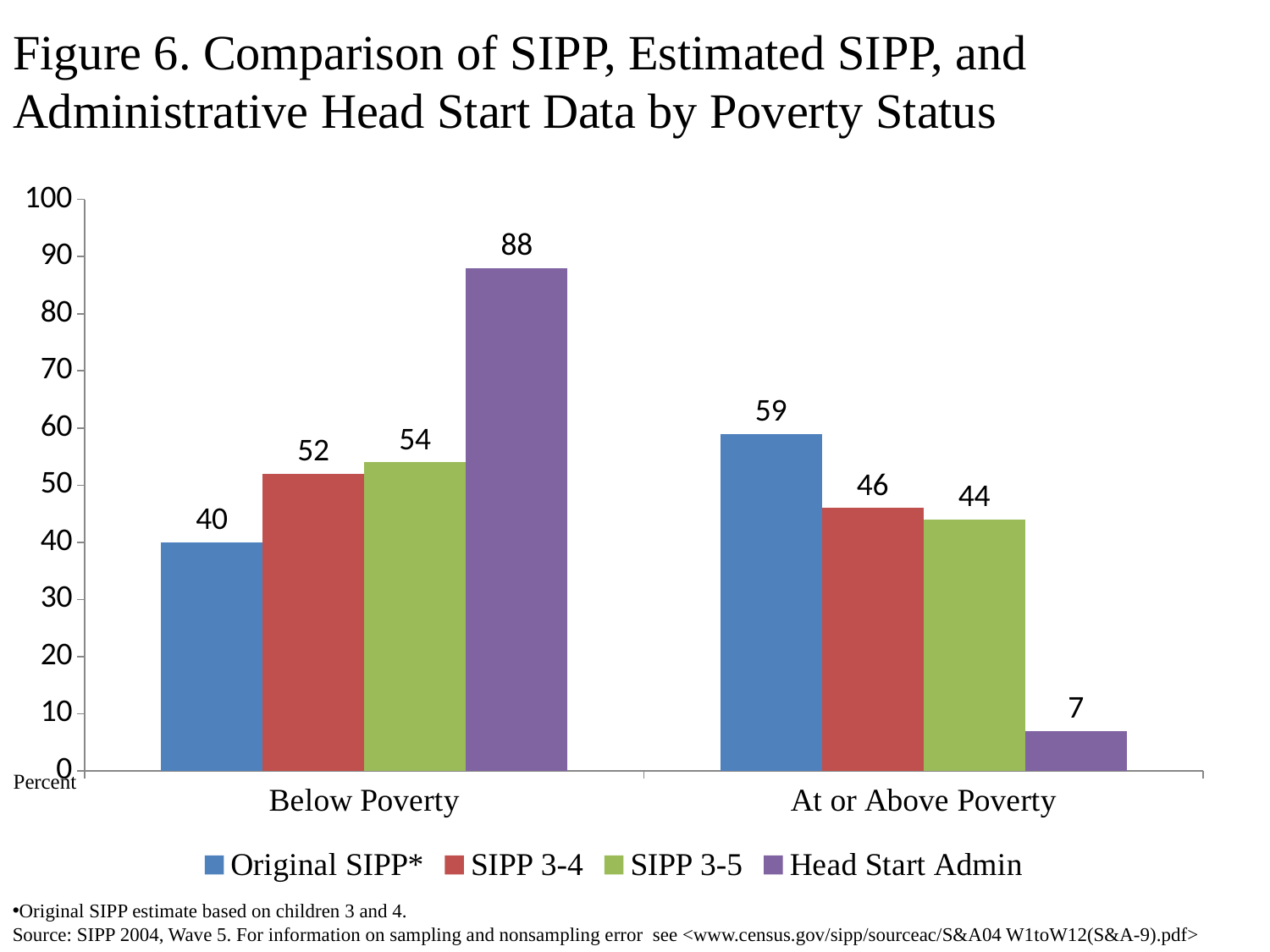
What is the Head Start Admin value for Below Poverty? 88 What is the SIPP 3-5 value for At or Above Poverty? 44 Which series has the lowest value for At or Above Poverty? Head Start Admin What colour are the Head Start Admin bars? Purple Which series has the highest value for Below Poverty? Head Start Admin What kind of chart is shown on the slide? Bar chart What is the SIPP 3-4 value for Below Poverty? 52 How many categories are shown on the x axis? 2 What is the Original SIPP* value for At or Above Poverty? 59 What is the difference between the Head Start Admin values for Below Poverty and At or Above Poverty? 81 How many series does the legend list? 4 Which is larger, the Original SIPP* value for Below Poverty or for At or Above Poverty? At or Above Poverty